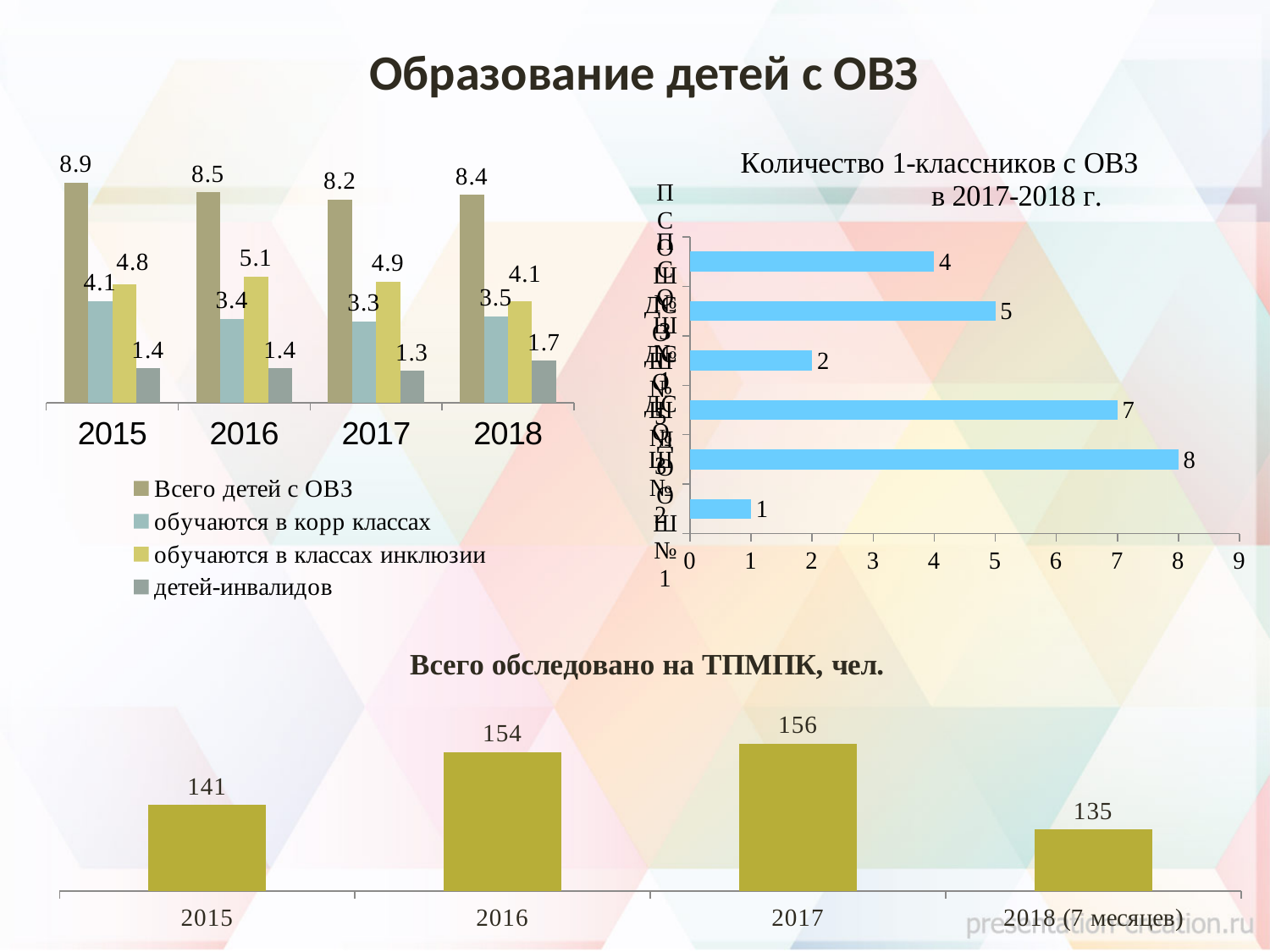
In the chart 'Всего обследовано на ТПМПК, чел.', which category has the lowest value? 2018 (7 месяцев) In the chart 'Всего обследовано на ТПМПК, чел.', what is the difference between 2016 and 2015? 13 In the chart 'Всего обследовано на ТПМПК, чел.', what is the value for 2017? 156 In the top-left chart, which year has the highest value for 'Всего детей с ОВЗ'? 2015 In the top-left chart, what is the value of 'обучаются в классах инклюзии' for 2016? 5.1 In the top-left chart, what is the value of 'Всего детей с ОВЗ' for 2015? 8.9 How many series does the legend of the top-left chart list? 4 In the chart 'Количество 1-классников с ОВЗ в 2017-2018 г.', what is the largest value shown? 8 In the top-left chart, what is the difference between 'Всего детей с ОВЗ' in 2015 and in 2017? 0.7 What kind of chart is 'Количество 1-классников с ОВЗ в 2017-2018 г.'? bar chart In the top-left chart, what is the value of 'детей-инвалидов' for 2018? 1.7 In the chart 'Количество 1-классников с ОВЗ в 2017-2018 г.', how many bars are plotted? 6